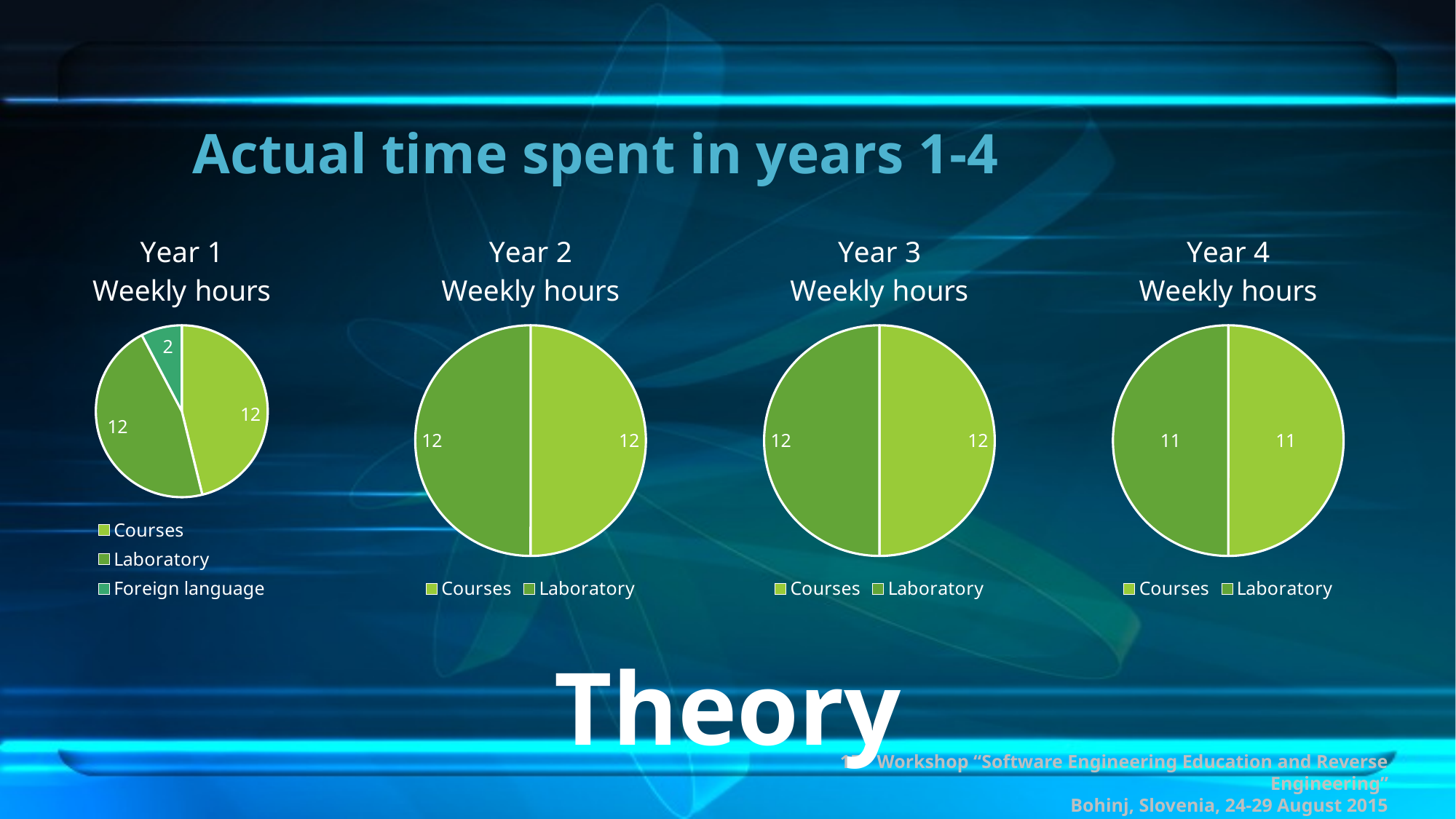
In the Year 1 Weekly hours chart, what is the difference between the Courses value and the Foreign language value? 10 How many categories does the Year 2 Weekly hours chart show? 2 In the Year 1 Weekly hours chart, is the value for Laboratory larger or smaller than the value for Foreign language? larger In the Year 3 Weekly hours chart, what is the value for Courses? 12 In the Year 4 Weekly hours chart, what share of the pie does Courses represent? 50% In the Year 1 Weekly hours chart, what is the value for Foreign language? 2 In the Year 1 Weekly hours chart, what is the total of all slices? 26 In the Year 4 Weekly hours chart, what is the value for Laboratory? 11 In the Year 1 Weekly hours chart, what is the value for Courses? 12 In the Year 1 Weekly hours chart, which category has the smallest slice? Foreign language How many categories does the Year 1 Weekly hours chart show? 3 What kind of chart is the Year 3 Weekly hours chart? pie chart